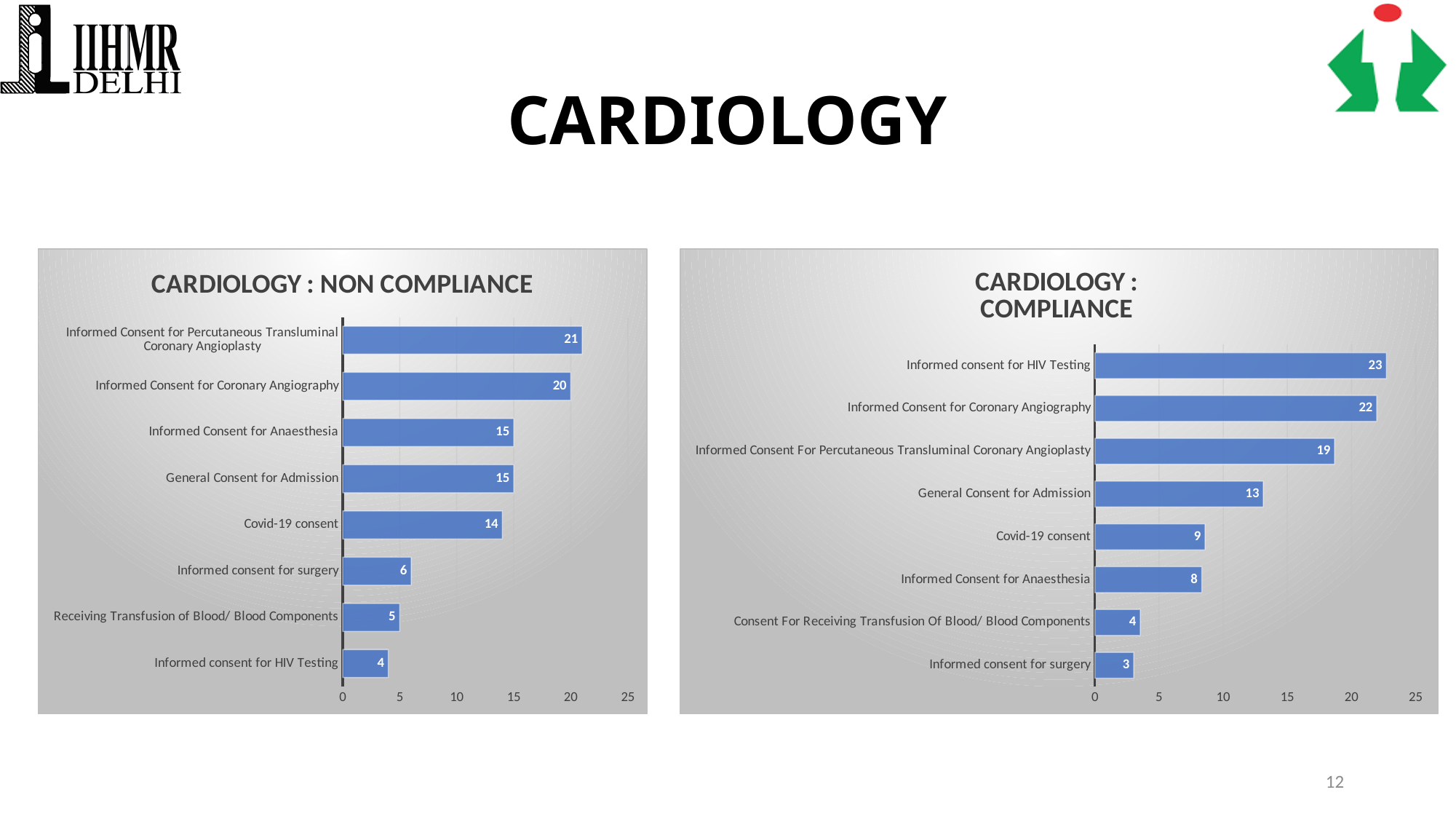
In the CARDIOLOGY : NON COMPLIANCE chart, how many categories are shown? 8 In the CARDIOLOGY : COMPLIANCE chart, which is larger: Covid-19 consent or Informed Consent for Anaesthesia? Covid-19 consent In the CARDIOLOGY : COMPLIANCE chart, which category has the highest value? Informed consent for HIV Testing In the CARDIOLOGY : NON COMPLIANCE chart, what is the value for Informed Consent for Coronary Angiography? 20 In the CARDIOLOGY : NON COMPLIANCE chart, which category has the lowest value? Informed consent for HIV Testing In the CARDIOLOGY : COMPLIANCE chart, what is the value for General Consent for Admission? 13 In the CARDIOLOGY : COMPLIANCE chart, which category has the lowest value? Informed consent for surgery In the CARDIOLOGY : NON COMPLIANCE chart, what is the difference between Covid-19 consent and Informed consent for surgery? 8 In the CARDIOLOGY : COMPLIANCE chart, what is the difference between Informed Consent for Coronary Angiography and Informed Consent For Percutaneous Transluminal Coronary Angioplasty? 3 In the CARDIOLOGY : COMPLIANCE chart, what is the value for Consent For Receiving Transfusion Of Blood/ Blood Components? 4 What kind of chart is the CARDIOLOGY : COMPLIANCE chart? Bar chart In the CARDIOLOGY : NON COMPLIANCE chart, which category has the highest value? Informed Consent for Percutaneous Transluminal Coronary Angioplasty